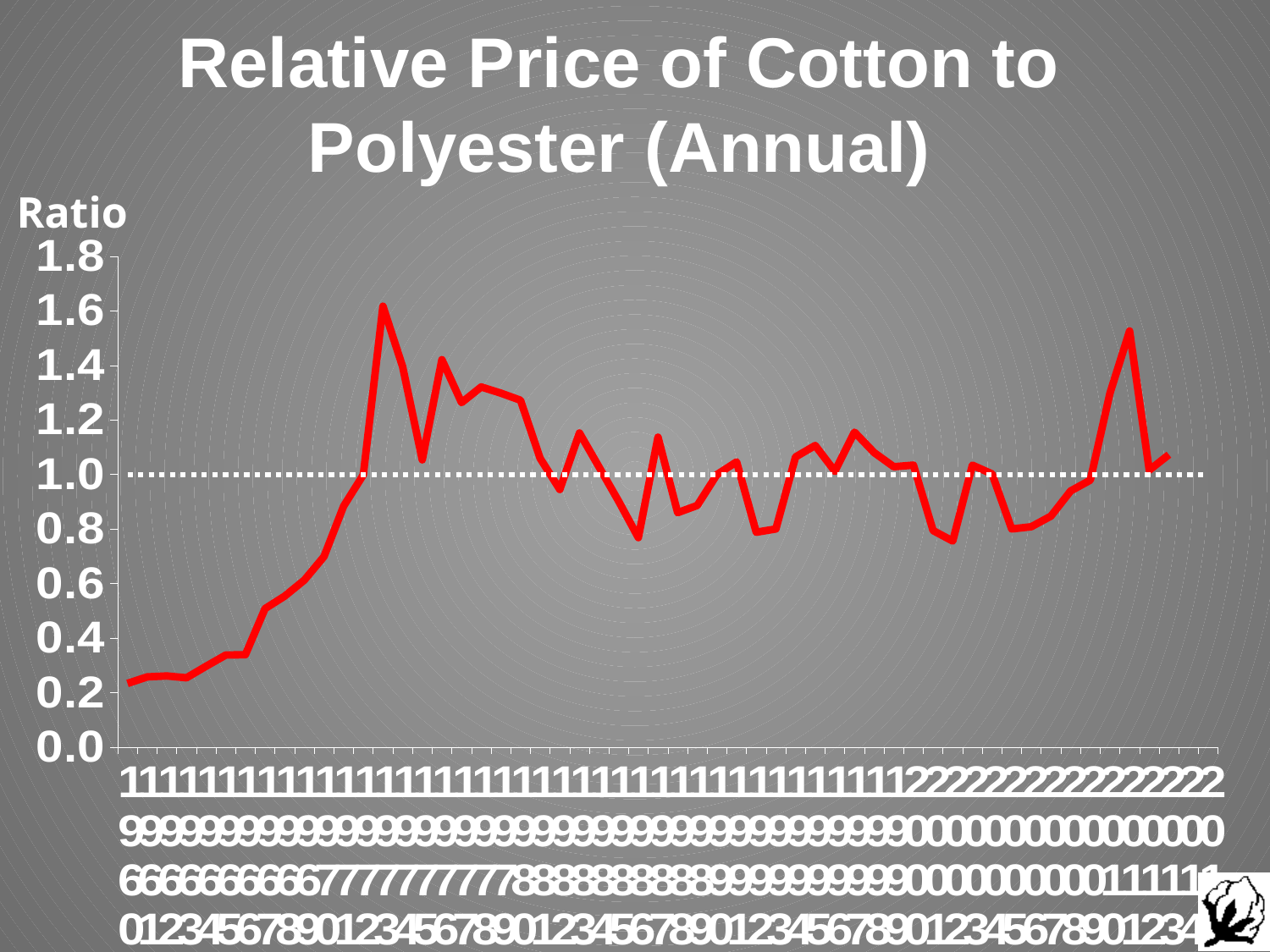
What is the highest value shown on the vertical axis? 1.8 Do the values rise or fall from the leftmost point up to the first major peak of the line? rise Is the value at the rightmost point of the line greater or less than 1.4? less Is the value at the leftmost point of the line (the first year) greater or less than 0.4? less What label is shown on the vertical axis of the chart? Ratio Is the value at the second tall peak near the right side of the chart greater or less than 1.2? greater What kind of chart is shown on the slide? line chart What is the title of the chart? Relative Price of Cotton to Polyester (Annual)